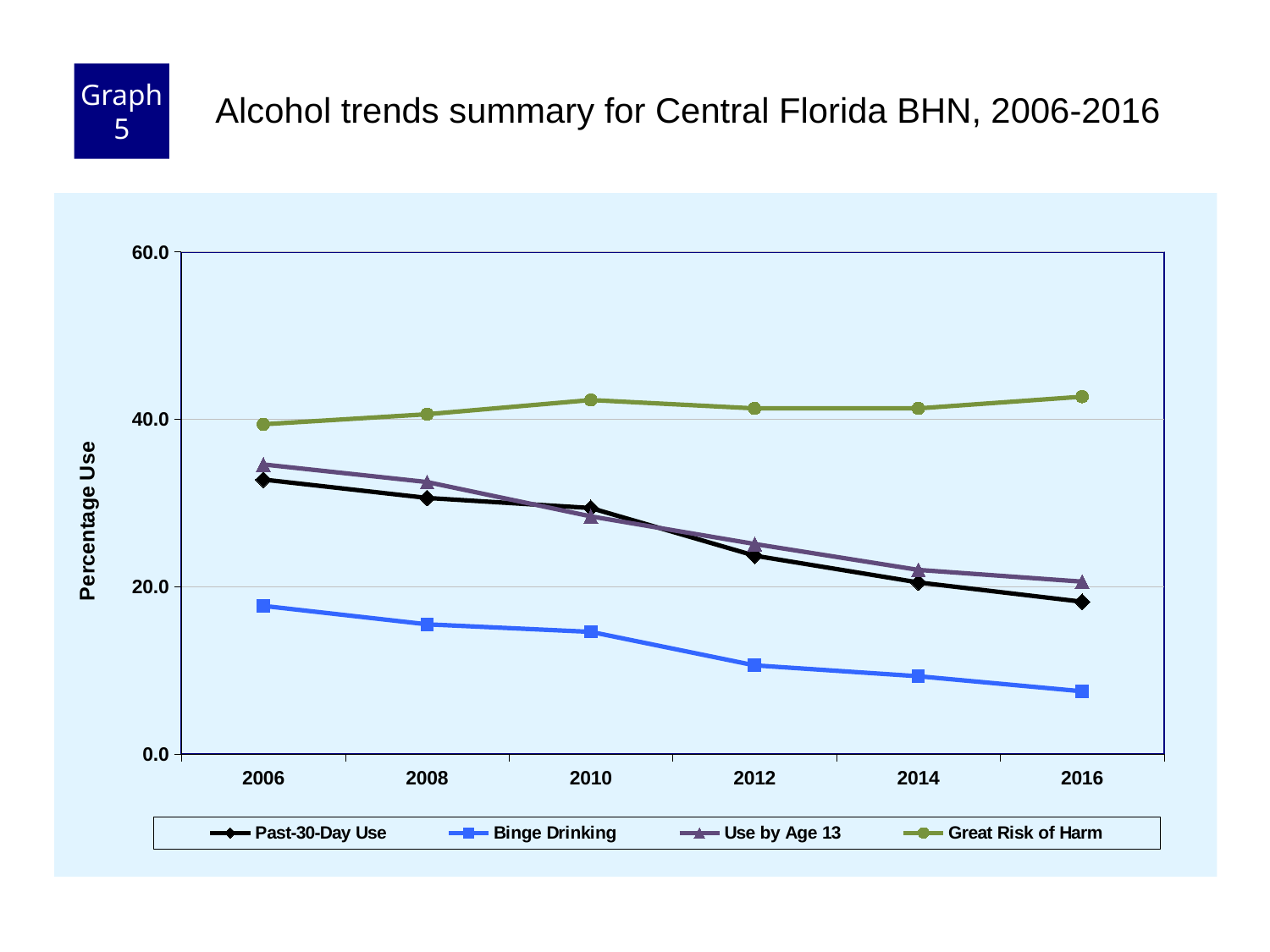
Which series has the highest value in 2016? Great Risk of Harm How many series does the legend list? 4 Does the Binge Drinking line rise or fall from 2006 to 2016? Fall In 2012, which is larger: Great Risk of Harm or Binge Drinking? Great Risk of Harm Which series has the lowest value in 2016? Binge Drinking What is the label on the y axis of the chart? Percentage Use Is the value for Great Risk of Harm in 2016 greater or less than 40.0? greater How many years are plotted along the x axis? 6 Is the value for Binge Drinking in 2016 greater or less than 20.0? less Does the Past-30-Day Use line rise or fall from 2006 to 2016? Fall Is the value for Past-30-Day Use in 2006 greater or less than 20.0? greater What kind of chart is shown on the slide? Line chart